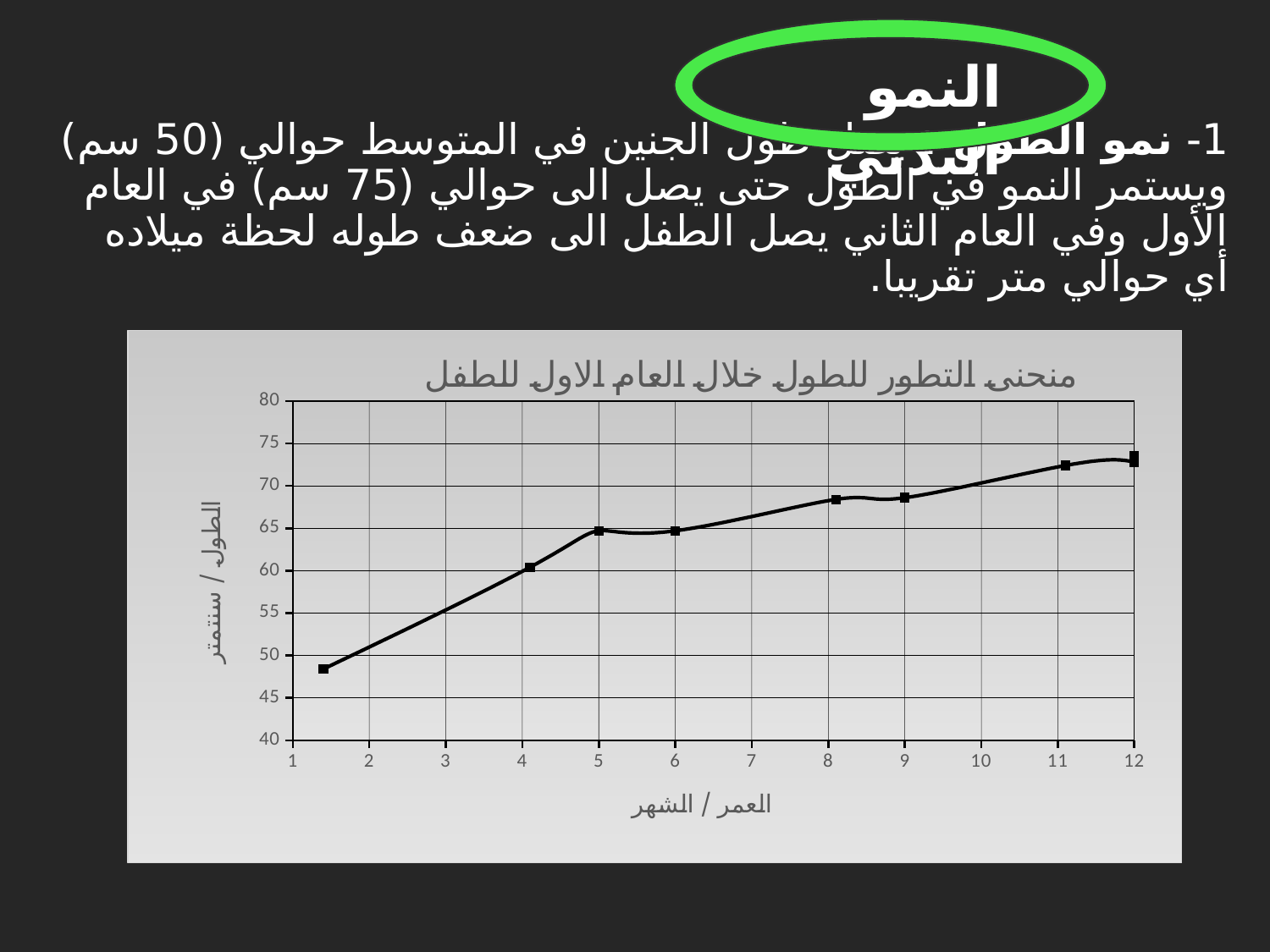
Do the values on the chart rise or fall as age in months increases along the x axis? rise What is the label of the vertical axis of the chart? الطول / سنتمتر Which plotted point has the highest value, the one at month 12 or the one at month 1? month 12 Is the value of the point plotted at month 5 greater or less than 60? greater What kind of chart is shown on the slide? line chart Is the value of the first plotted point (near month 1) greater or less than 50? less Is the value of the last plotted point (month 12) greater or less than 70? greater What is the title of the chart? منحنى التطور للطول خلال العام الاول للطفل